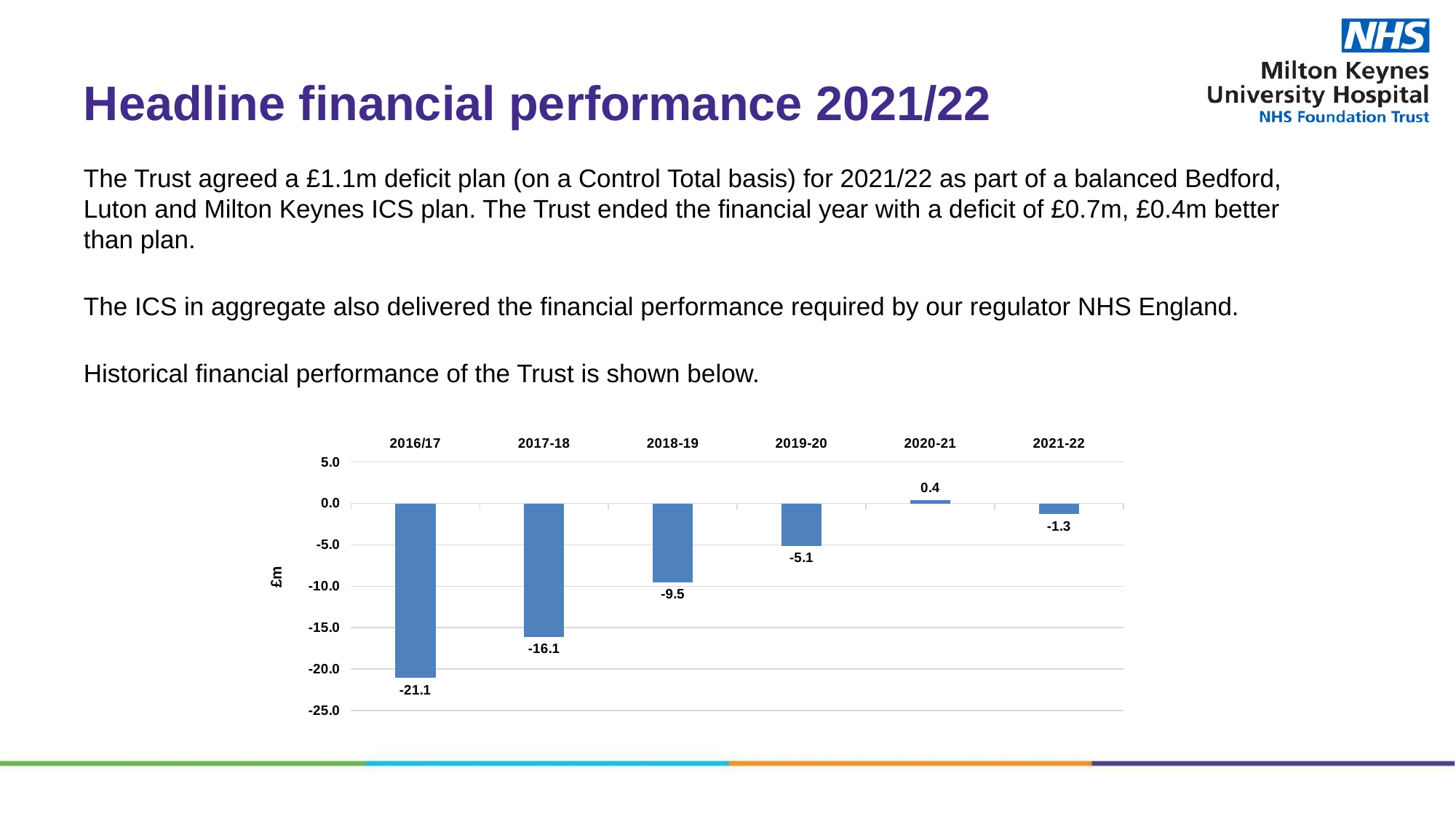
What is the value for 2016/17 in the chart? -21.1 What is the value for 2020-21 in the chart? 0.4 What is the value for 2021-22 in the chart? -1.3 What is the difference between the values for 2017-18 and 2016/17? 5.0 Which year has the highest value in the chart? 2020-21 What kind of chart is shown on the slide? Bar chart Which is larger, the value for 2019-20 or the value for 2018-19? 2019-20 What is the value for 2017-18 in the chart? -16.1 What is the value for 2018-19 in the chart? -9.5 Which year has the lowest value in the chart? 2016/17 What is the label on the vertical axis of the chart? £m How many years are shown in the chart? 6